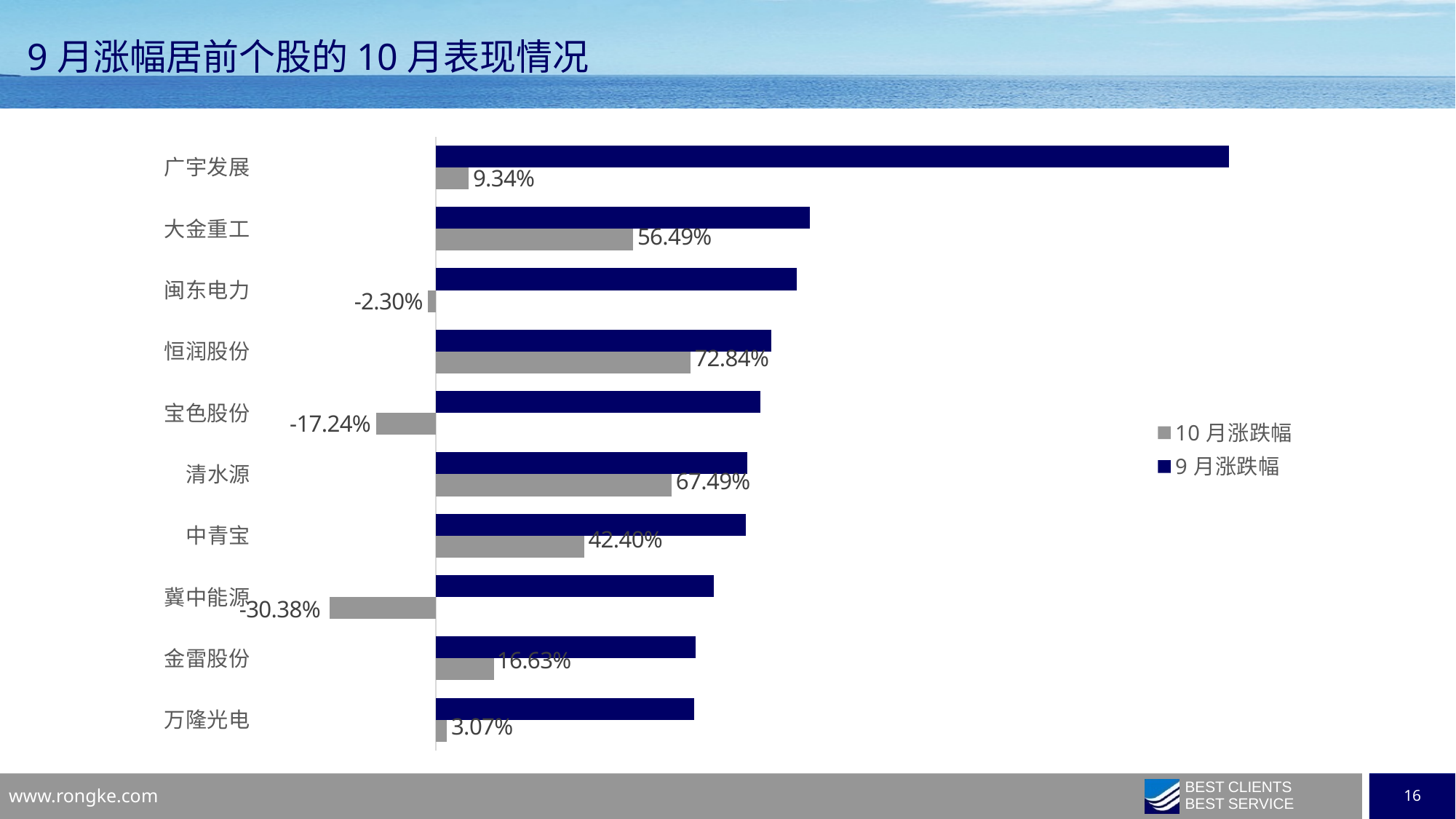
Which stock has the highest 9月涨跌幅? 广宇发展 What kind of chart is shown on the slide? Bar chart Which stock has the highest 10月涨跌幅? 恒润股份 How many stocks are shown in the chart? 10 What is the 10月涨跌幅 value for 恒润股份? 72.84% How many series does the legend list? 2 What is the difference between the 10月涨跌幅 of 恒润股份 and 清水源? 5.35% Which stock has the lowest 10月涨跌幅? 冀中能源 What is the 10月涨跌幅 value for 宝色股份? -17.24% Which has a larger 10月涨跌幅, 大金重工 or 中青宝? 大金重工 What is the 10月涨跌幅 value for 冀中能源? -30.38% What is the 10月涨跌幅 value for 广宇发展? 9.34%